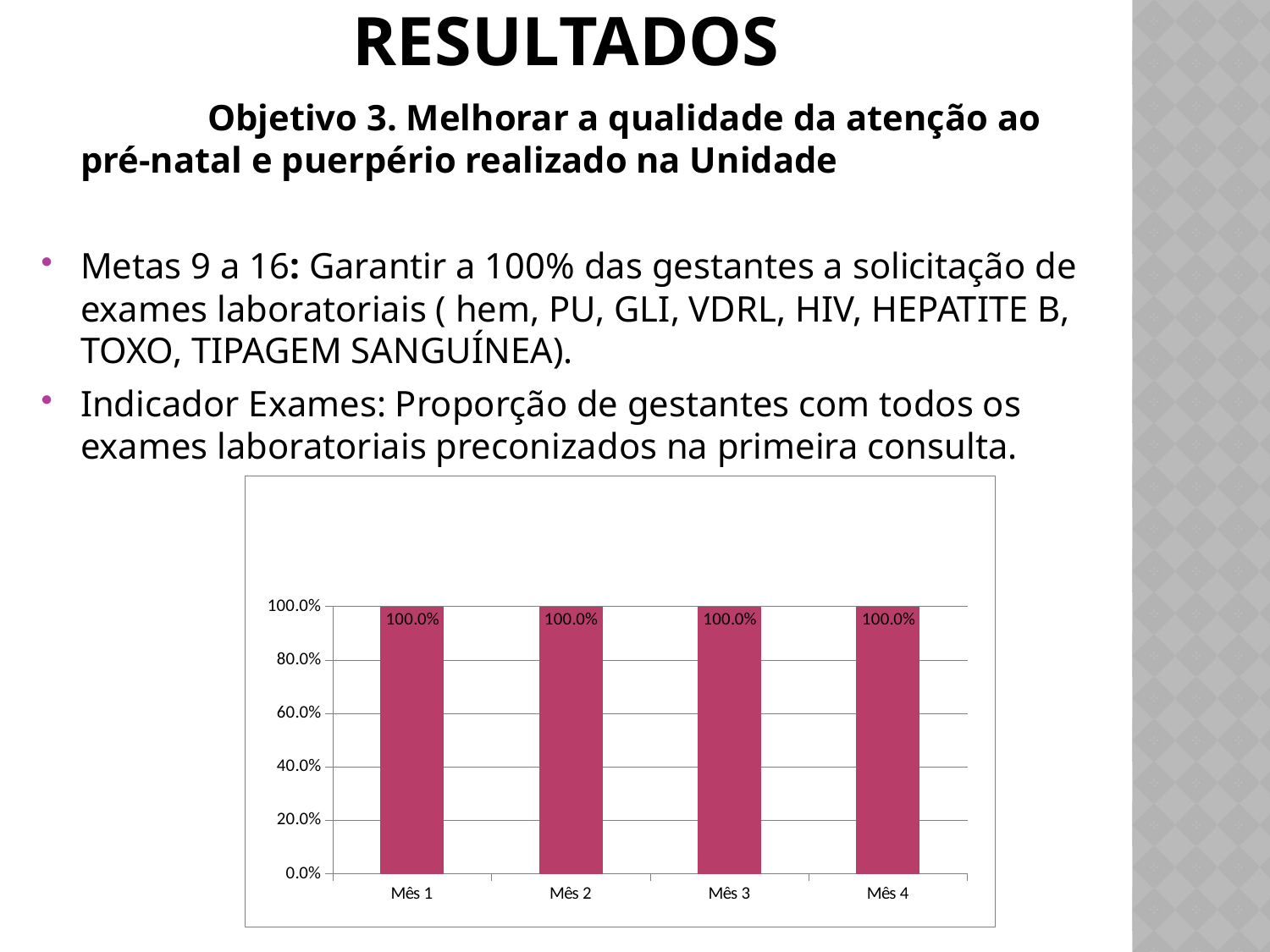
How many categories are shown on the x axis of the chart? 4 Is the value for Mês 2 greater or less than 80.0%? greater What is the value for Mês 1? 100.0% What kind of chart is shown on the slide? bar chart What is the value for Mês 4? 100.0% What is the value for Mês 3? 100.0% What is the difference between the values for Mês 2 and Mês 4? 0.0% What is the highest value shown on the y axis of the chart? 100.0% What colour are the bars in the chart? magenta/pink Do the values rise, fall, or stay the same from Mês 1 to Mês 4? stay the same